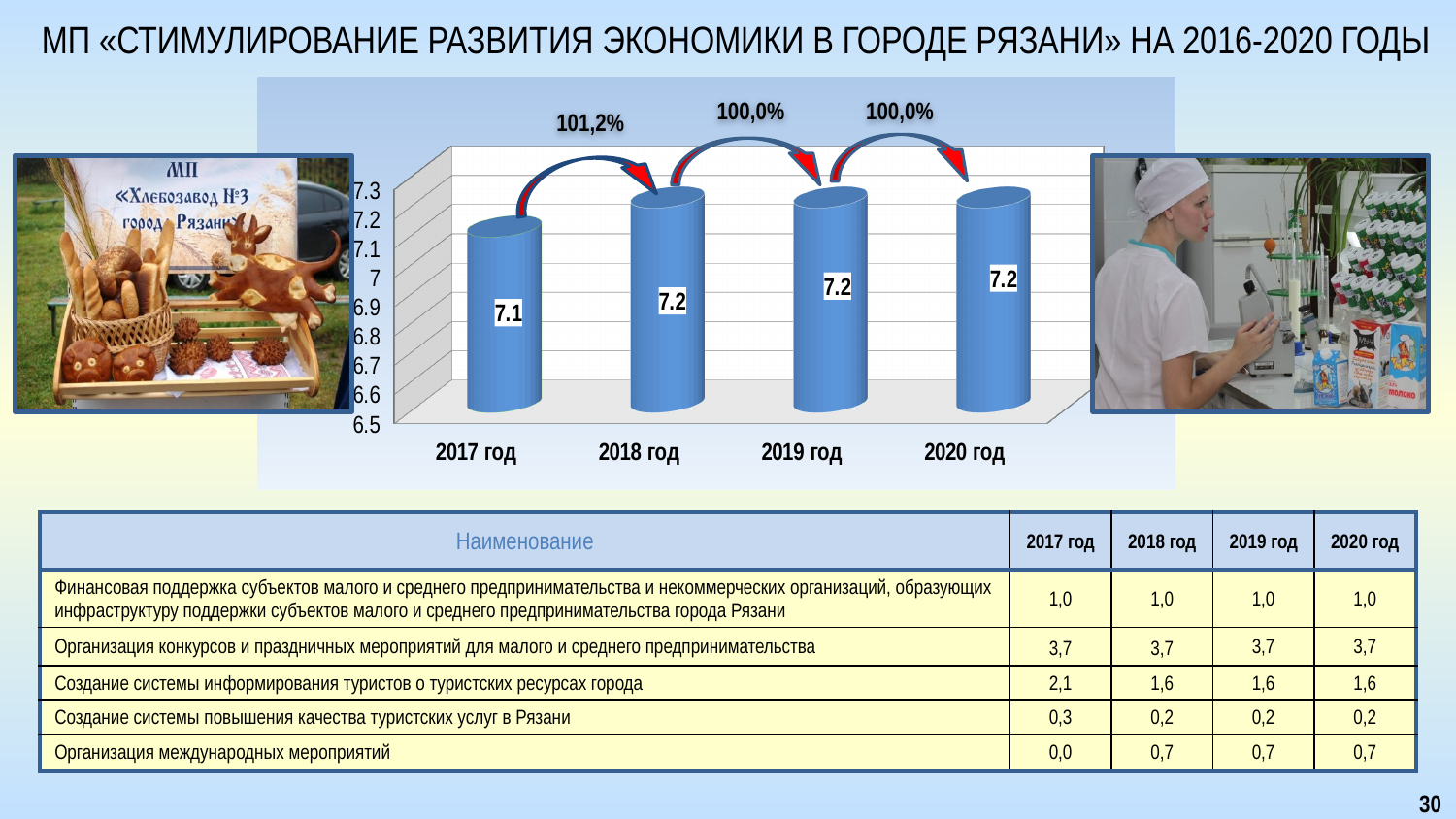
What is the value for 2018 год? 7.2 What is the difference between the values for 2018 год and 2017 год? 0.1 What is the value for 2017 год? 7.1 Do the values rise or fall from 2017 год to 2018 год? rise Is the value for 2017 год greater or less than 7? greater What percentage label is shown on the arrow between 2017 год and 2018 год? 101,2% How many years are shown on the x axis of the chart? 4 What is the value for 2020 год? 7.2 What is the highest tick value shown on the vertical axis of the chart? 7.3 Which year has the lowest value? 2017 год Which is larger, the value for 2017 год or the value for 2019 год? 2019 год What kind of chart is shown on the slide? bar chart